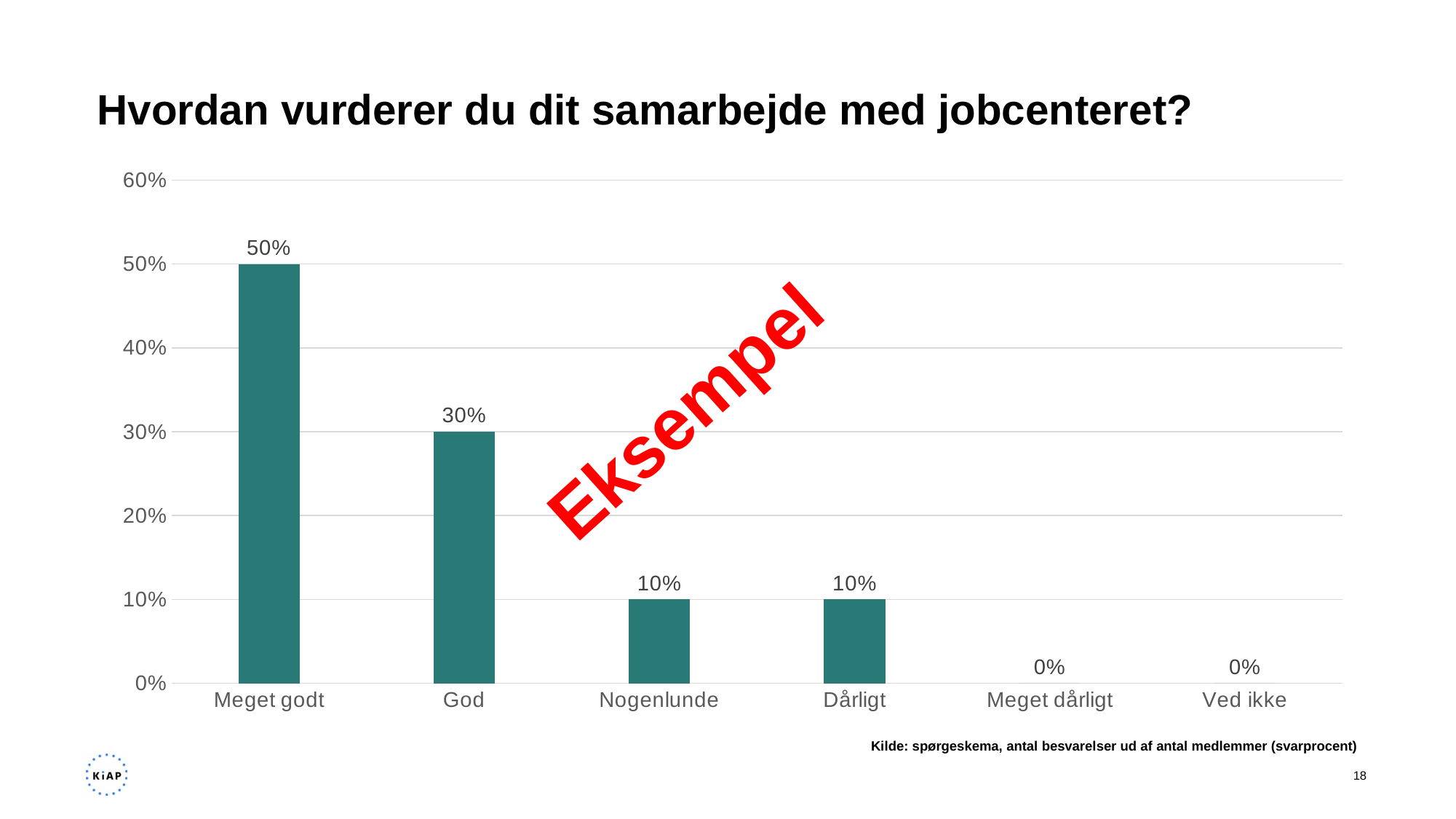
How many categories are shown on the x axis? 6 Which is larger, the value for "God" or the value for "Dårligt"? God What is the value for "Meget godt"? 50% Do the values rise or fall from "Meget godt" to "Ved ikke" along the x axis? Fall What is the title of the chart? Hvordan vurderer du dit samarbejde med jobcenteret? What is the value for "God"? 30% What is the value for "Meget dårligt"? 0% Is the value for "God" greater or less than 20%? greater What is the difference between the values for "Meget godt" and "God"? 20% Which category has the highest value? Meget godt What is the value for "Nogenlunde"? 10% What kind of chart is shown on the slide? Bar chart